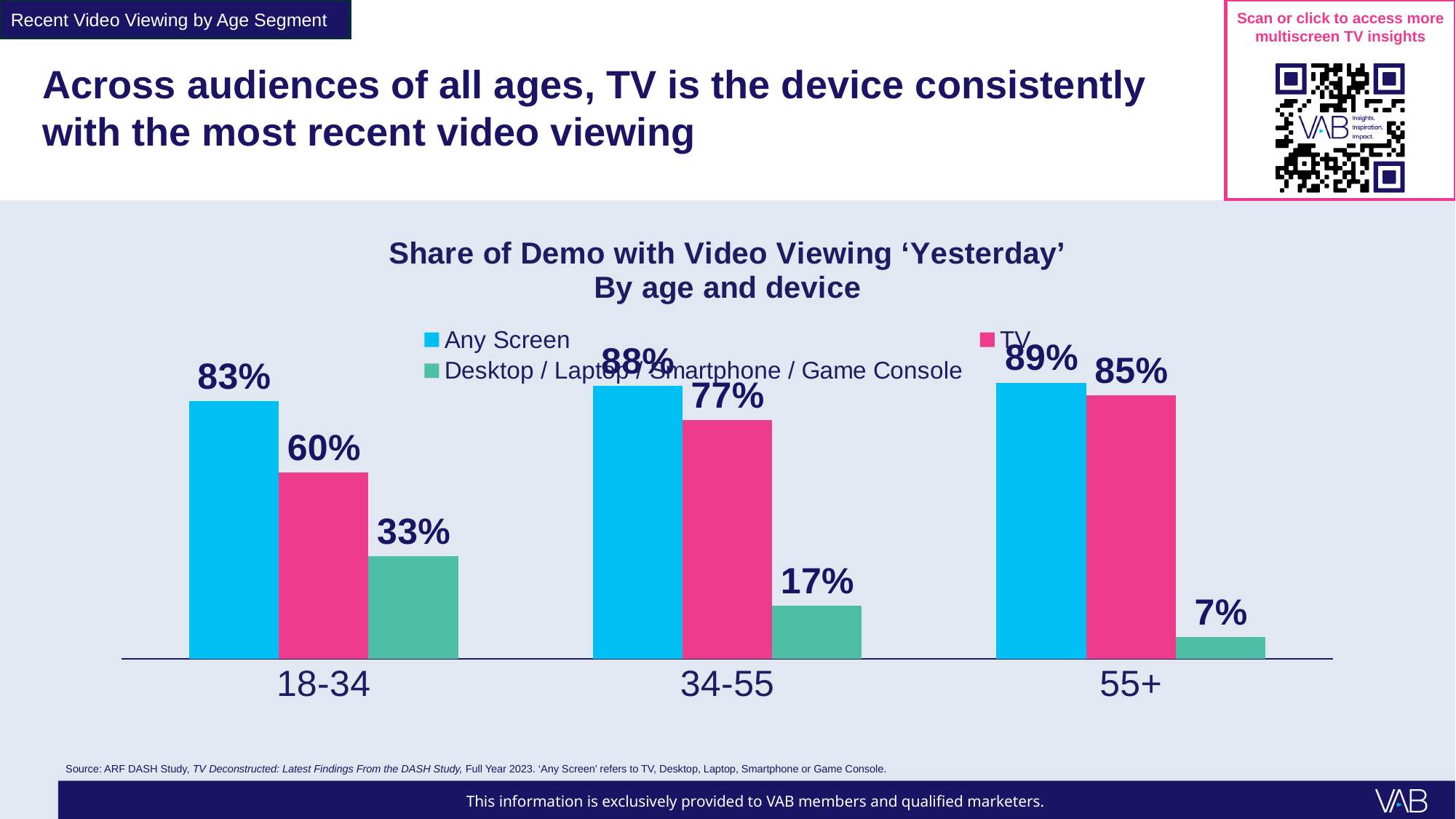
What is the Any Screen value for the 18-34 age group? 83% Which age group has the lowest Desktop / Laptop / Smartphone / Game Console value? 55+ What is the TV value for the 34-55 age group? 77% Which age group has the highest TV value? 55+ How many series does the legend list? 3 What kind of chart is shown on the slide? Bar chart Do the Desktop / Laptop / Smartphone / Game Console values rise or fall from 18-34 to 55+? Fall What is the difference between the Any Screen and TV values for the 18-34 age group? 23% What is the Desktop / Laptop / Smartphone / Game Console value for the 55+ age group? 7% How many age groups are shown on the x axis? 3 Which is larger for the 34-55 age group: the TV value or the Desktop / Laptop / Smartphone / Game Console value? TV What is the title of the chart? Share of Demo with Video Viewing 'Yesterday' By age and device